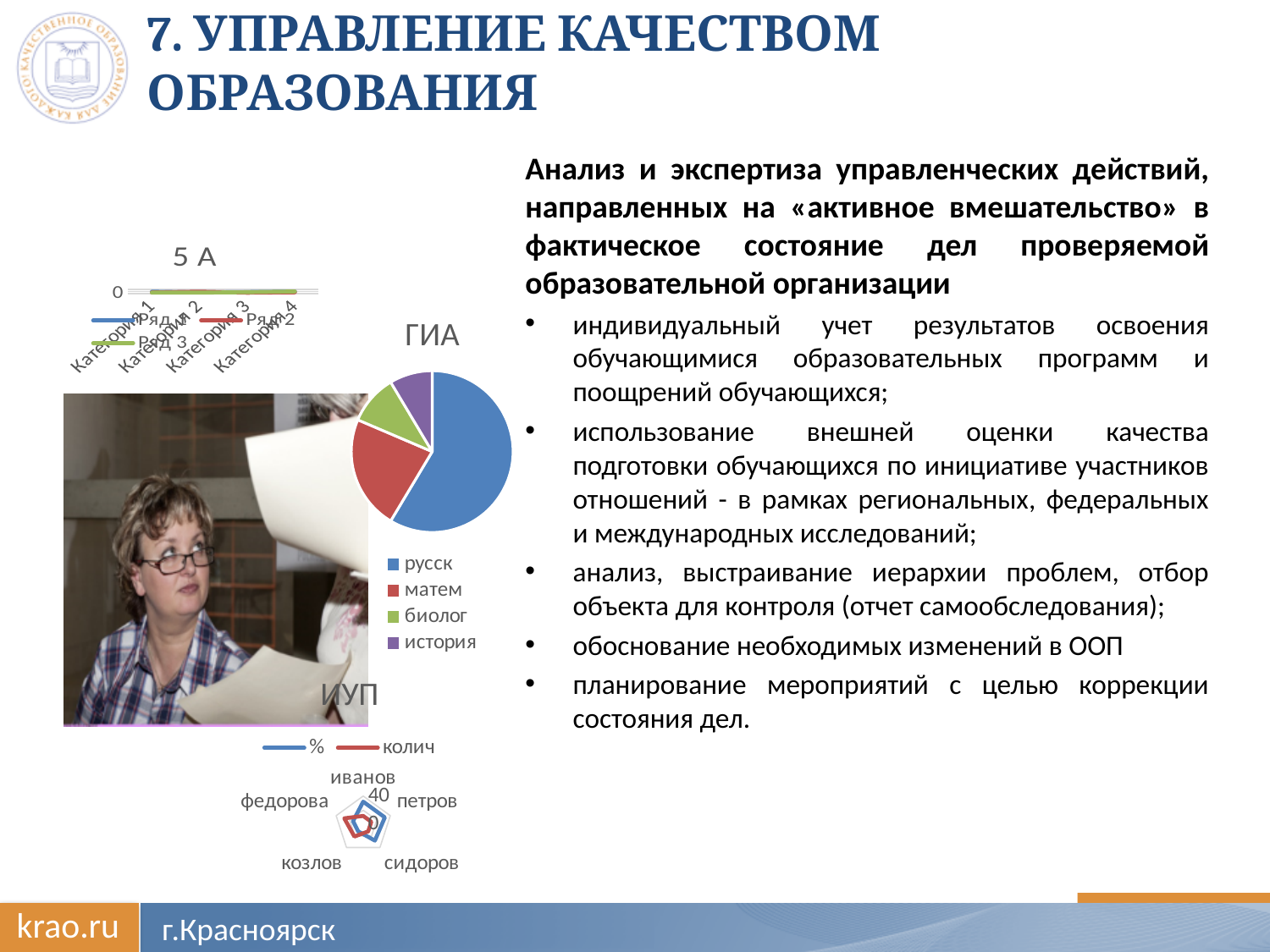
What type of chart is the chart titled ИУП? radar chart In the ГИА pie chart, which category has the largest slice? русск In the ГИА pie chart, which slice is larger, русск or матем? русск In the ГИА pie chart, which category has the smallest slice? история What type of chart is the chart titled ГИА? pie chart How many series does the legend of the chart titled 5 А list? 3 How many categories are shown on the x axis of the chart titled 5 А? 4 What are the two series named in the legend of the ИУП chart? % and колич How many categories does the legend of the ГИА pie chart list? 4 How many categories are shown around the ИУП radar chart? 5 How many series does the legend of the ИУП chart list? 2 In the ГИА pie chart, which slice is larger, матем or биолог? матем